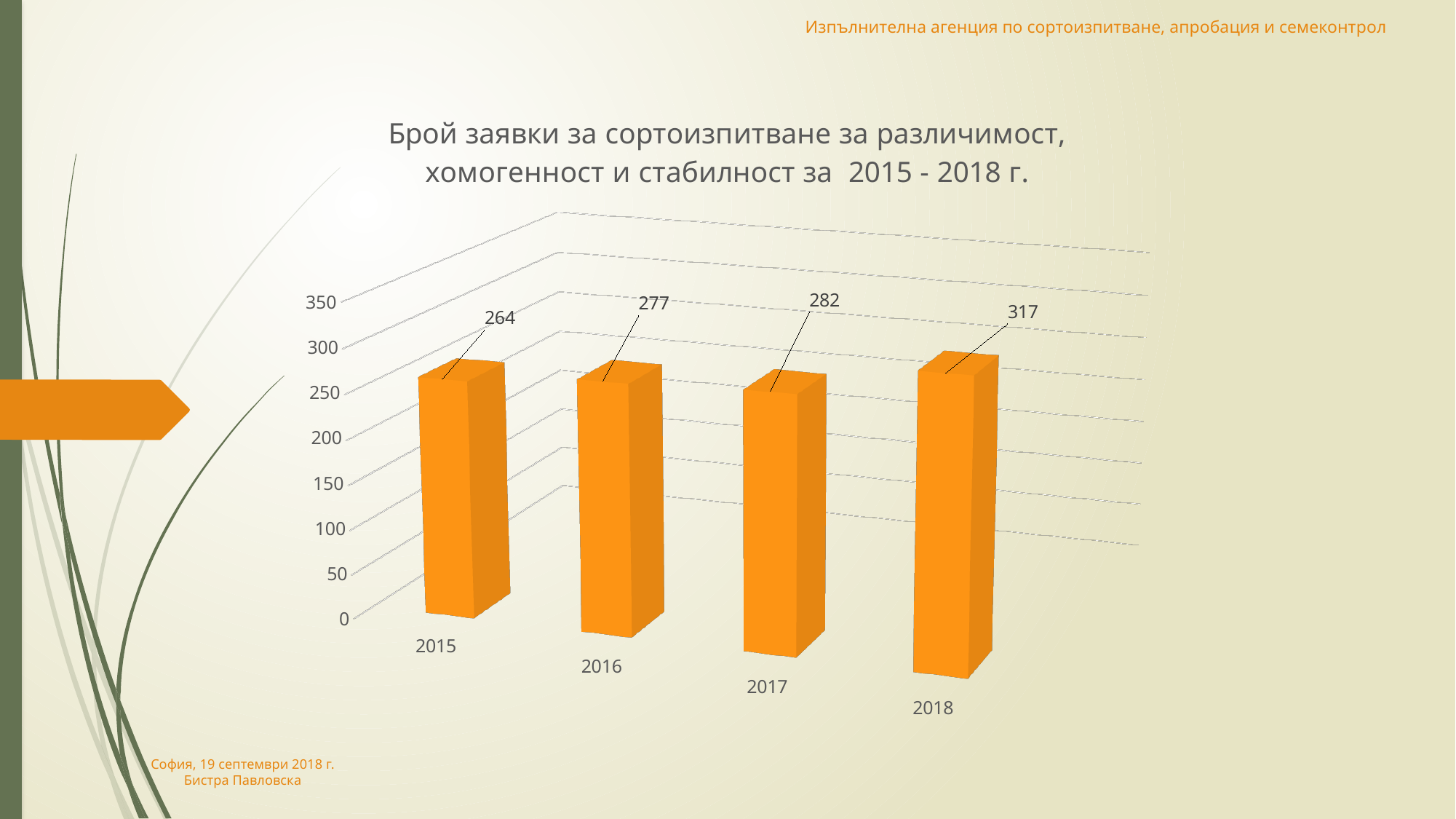
What is the difference between the values for 2018 and 2015? 53 What is the value for 2017? 282 What kind of chart is this? bar chart How many years are shown on the chart? 4 Which is larger, the value for 2016 or the value for 2018? 2018 Which year has the highest value? 2018 What is the value for 2016? 277 What is the value for 2015? 264 What is the difference between the values for 2017 and 2016? 5 Do the values rise or fall from 2015 to 2018? rise What is the value for 2018? 317 Which year has the lowest value? 2015